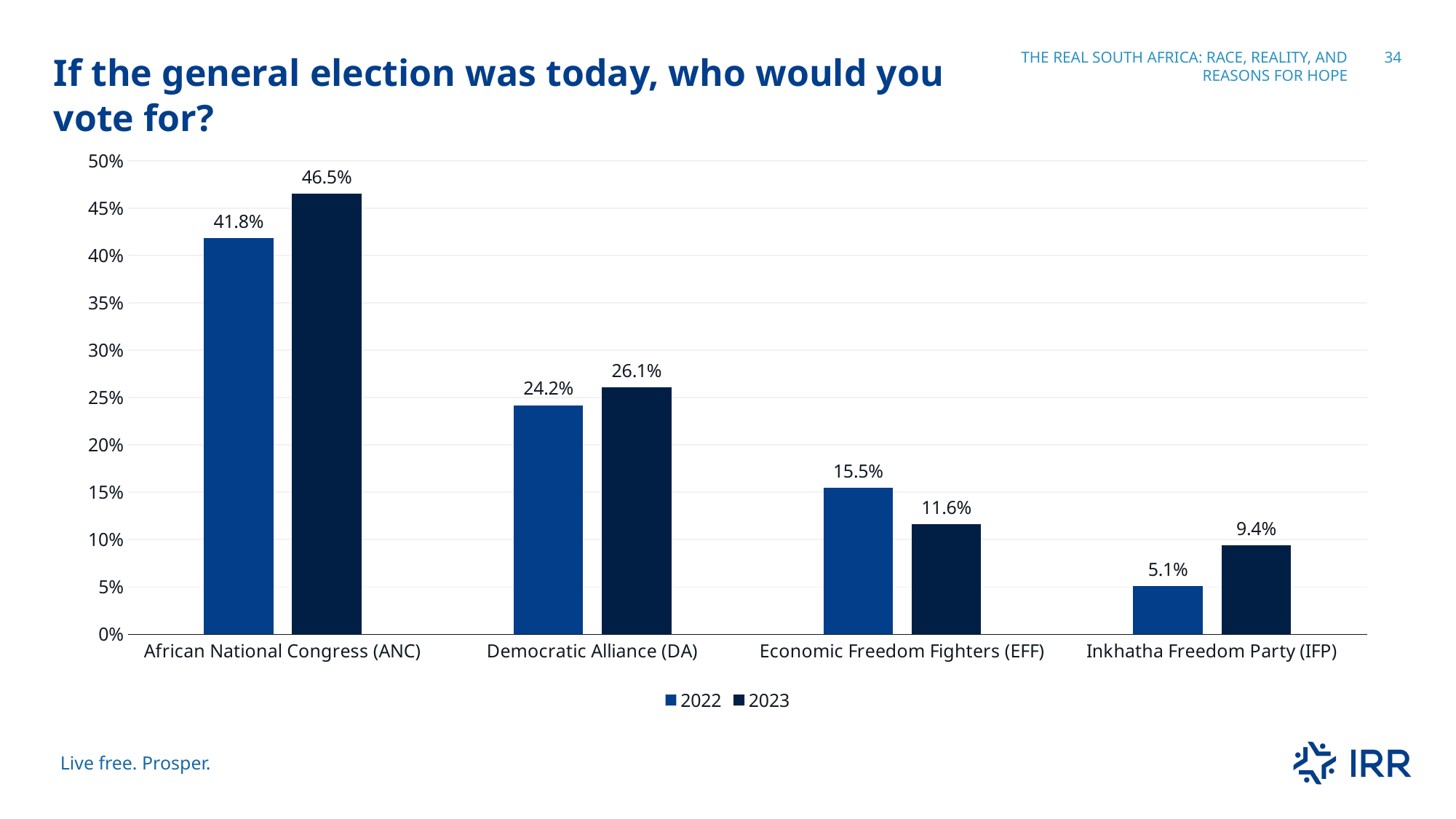
How many parties are shown on the x axis? 4 How many series does the legend list? 2 Which party has the highest 2023 value? African National Congress (ANC) Which party has the lowest 2022 value? Inkhatha Freedom Party (IFP) What is the 2022 value for Democratic Alliance (DA)? 24.2% Which is larger for Economic Freedom Fighters (EFF): the 2022 value or the 2023 value? 2022 What is the 2023 value for African National Congress (ANC)? 46.5% What kind of chart is shown on the slide? Bar chart Is the 2023 value for Democratic Alliance (DA) greater or less than 25%? greater What is the 2022 value for Inkhatha Freedom Party (IFP)? 5.1% What is the 2023 value for Economic Freedom Fighters (EFF)? 11.6% What is the difference between the 2023 and 2022 values for African National Congress (ANC)? 4.7%